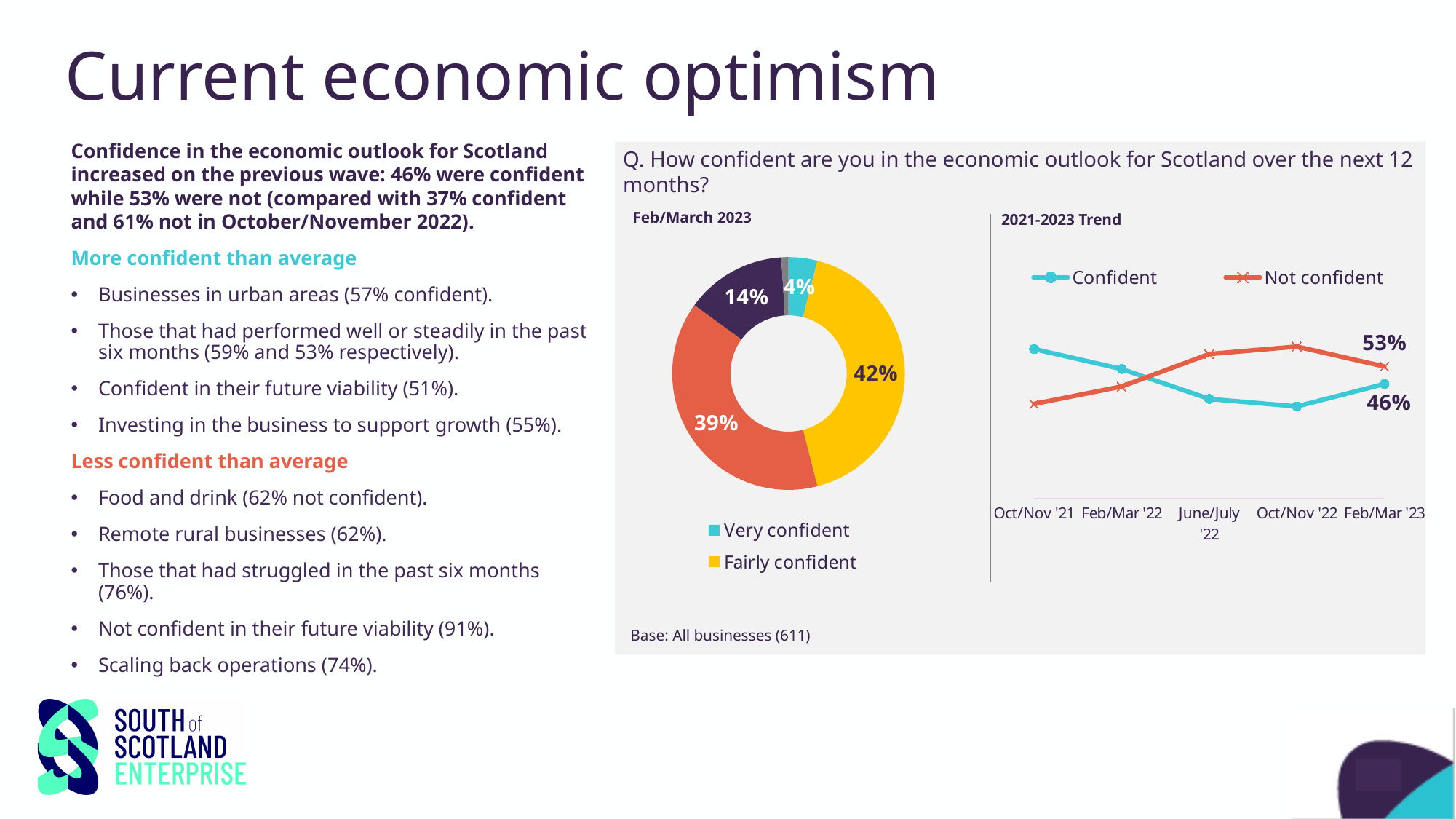
In the Feb/March 2023 donut chart, what share of businesses were fairly confident? 42% In the 2021-2023 Trend chart, how many series does the legend list? 2 In the Feb/March 2023 donut chart, what value is shown on the red slice? 39% In the 2021-2023 Trend chart, what is the value for Not confident at Feb/Mar '23? 53% In the 2021-2023 Trend chart, which series is higher at Oct/Nov '21, Confident or Not confident? Confident In the Feb/March 2023 donut chart, what share of businesses were very confident? 4% In the 2021-2023 Trend chart, how many time points are shown on the x axis? 5 In the Feb/March 2023 donut chart, what value is shown on the dark purple slice? 14% In the Feb/March 2023 donut chart, what is the value of the largest slice? 42% In the 2021-2023 Trend chart, what is the value for Confident at Feb/Mar '23? 46% What kind of chart is the Feb/March 2023 chart? Donut (pie) chart In the Feb/March 2023 donut chart, what is the difference between the fairly confident and very confident shares? 38 percentage points